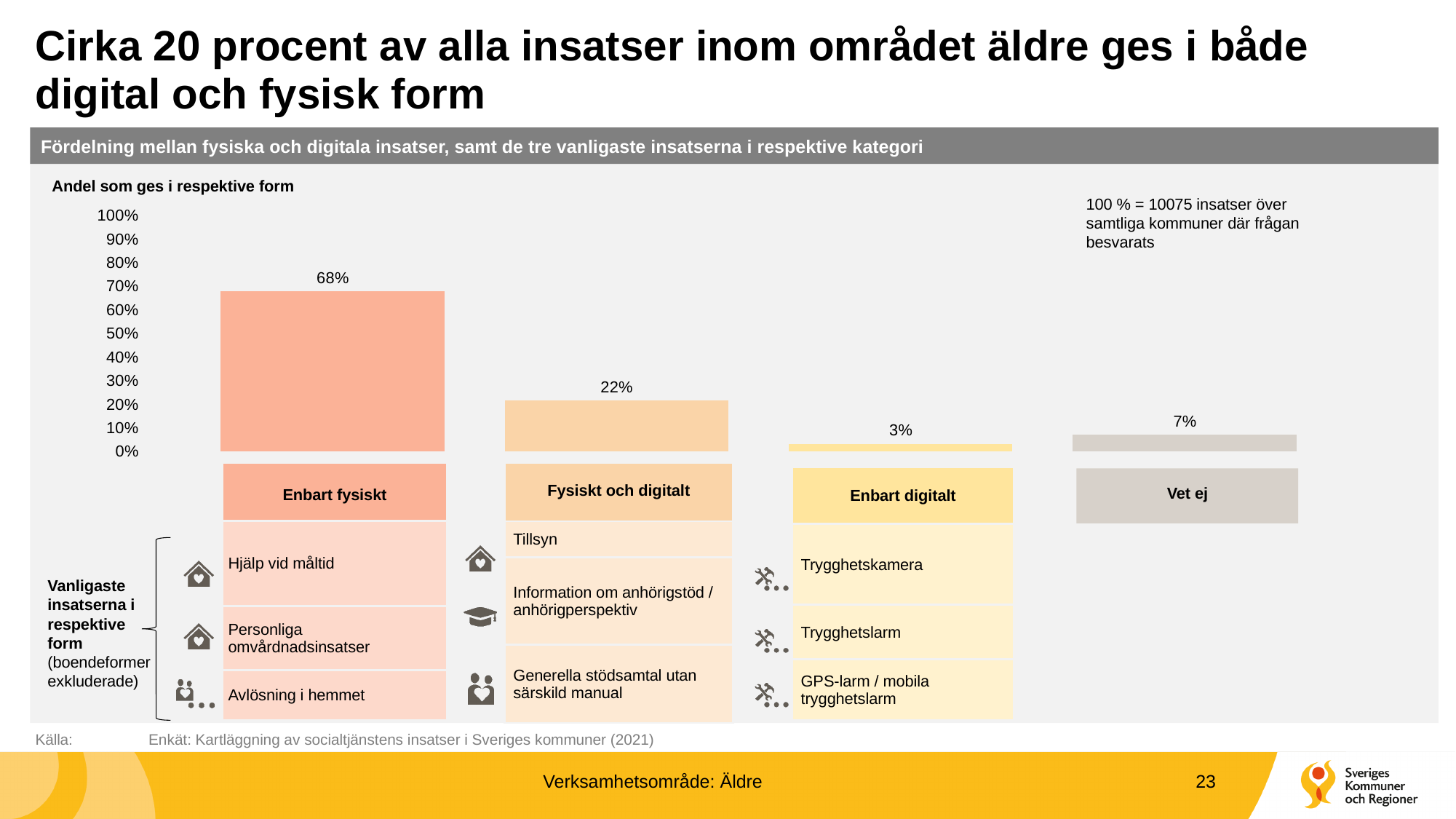
Which category has the highest value? Enbart fysiskt What is the value for Enbart digitalt? 3% What is the difference between Enbart fysiskt and Fysiskt och digitalt? 46% Which category has the lowest value? Enbart digitalt Which is larger, Vet ej or Enbart digitalt? Vet ej Is the value for Enbart fysiskt greater or less than 60%? greater What is the value for Vet ej? 7% What kind of chart is shown on the slide? Bar chart What does 100% correspond to according to the note on the chart? 10075 insatser What is the value for Fysiskt och digitalt? 22% How many categories are shown in the chart? 4 What is the value for Enbart fysiskt? 68%